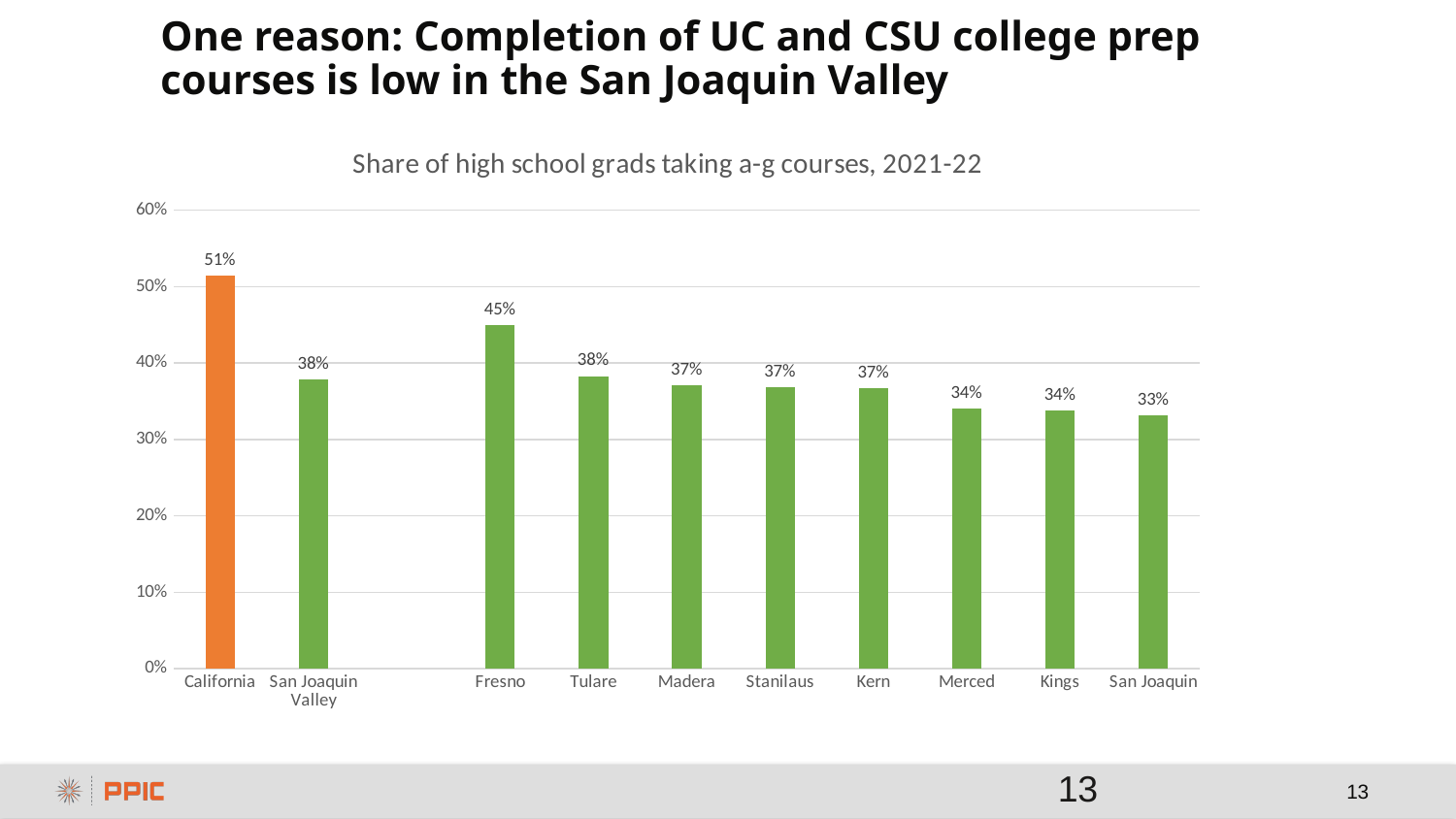
Which has a larger value, Fresno or Tulare? Fresno What is the share of high school grads taking a-g courses for California? 51% What is the value shown for San Joaquin Valley? 38% What is the difference between the values for California and San Joaquin Valley? 13% What is the value shown for Fresno? 45% How many categories are shown on the x axis? 10 What is the difference between the values for Fresno and Kings? 11% What is the value shown for Merced? 34% What is the title of the chart? Share of high school grads taking a-g courses, 2021-22 Which category has the highest value on the chart? California What kind of chart is shown on the slide? Bar chart Which category has the lowest value on the chart? San Joaquin